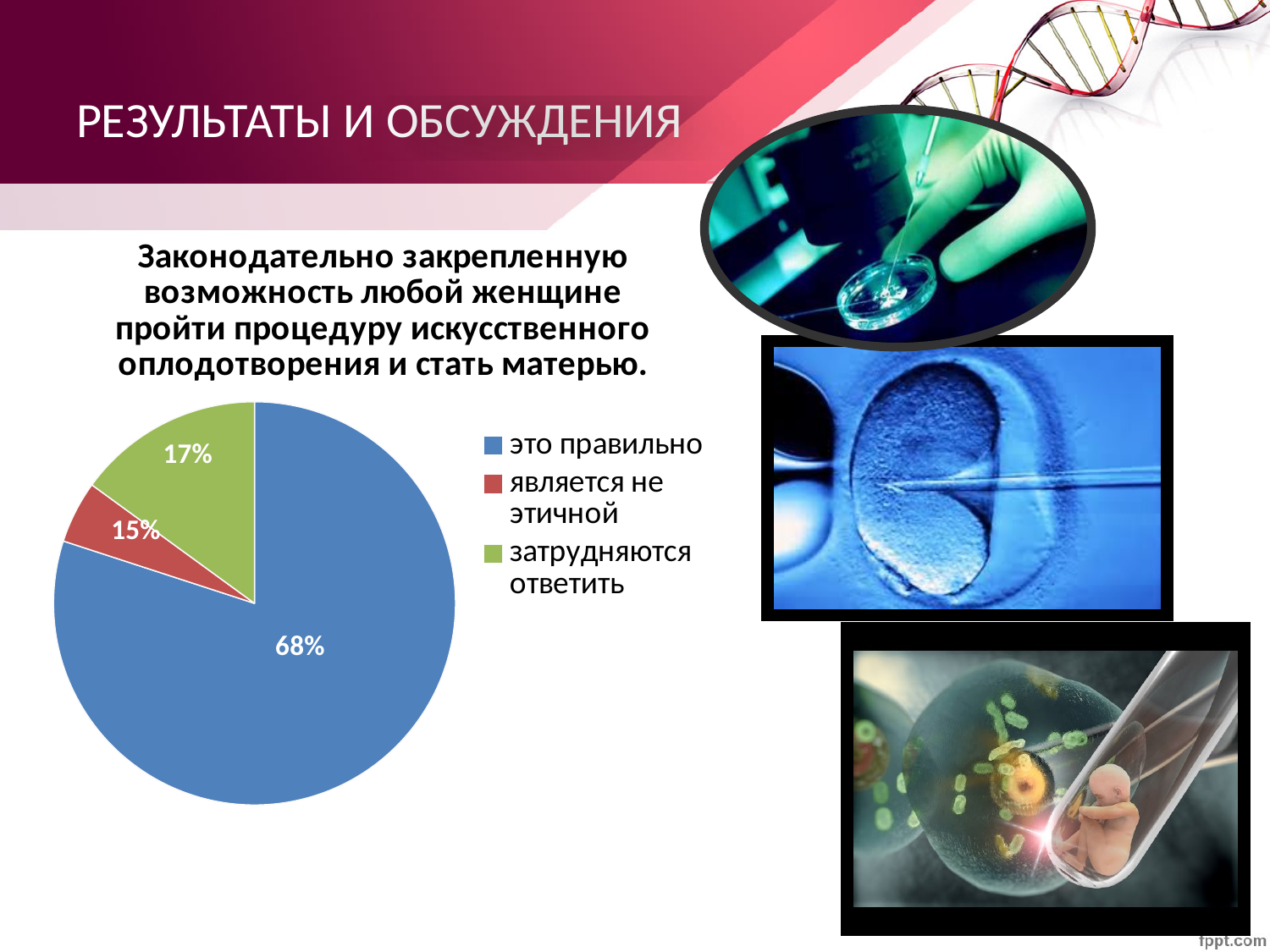
Which response has the smallest share of the pie? является не этичной What share of respondents answered "является не этичной"? 15% What share of respondents answered "затрудняются ответить"? 17% Which response has the largest share of the pie? это правильно How many entries does the legend list? 3 How many slices does the pie chart have? 3 What is the difference in percentage points between "это правильно" and "затрудняются ответить"? 51 Which is larger: the share for "затрудняются ответить" or for "является не этичной"? затрудняются ответить What colour is the slice for "затрудняются ответить"? green What share of respondents answered "это правильно"? 68% What kind of chart is shown on the slide? pie chart What colour is the slice for "это правильно"? blue